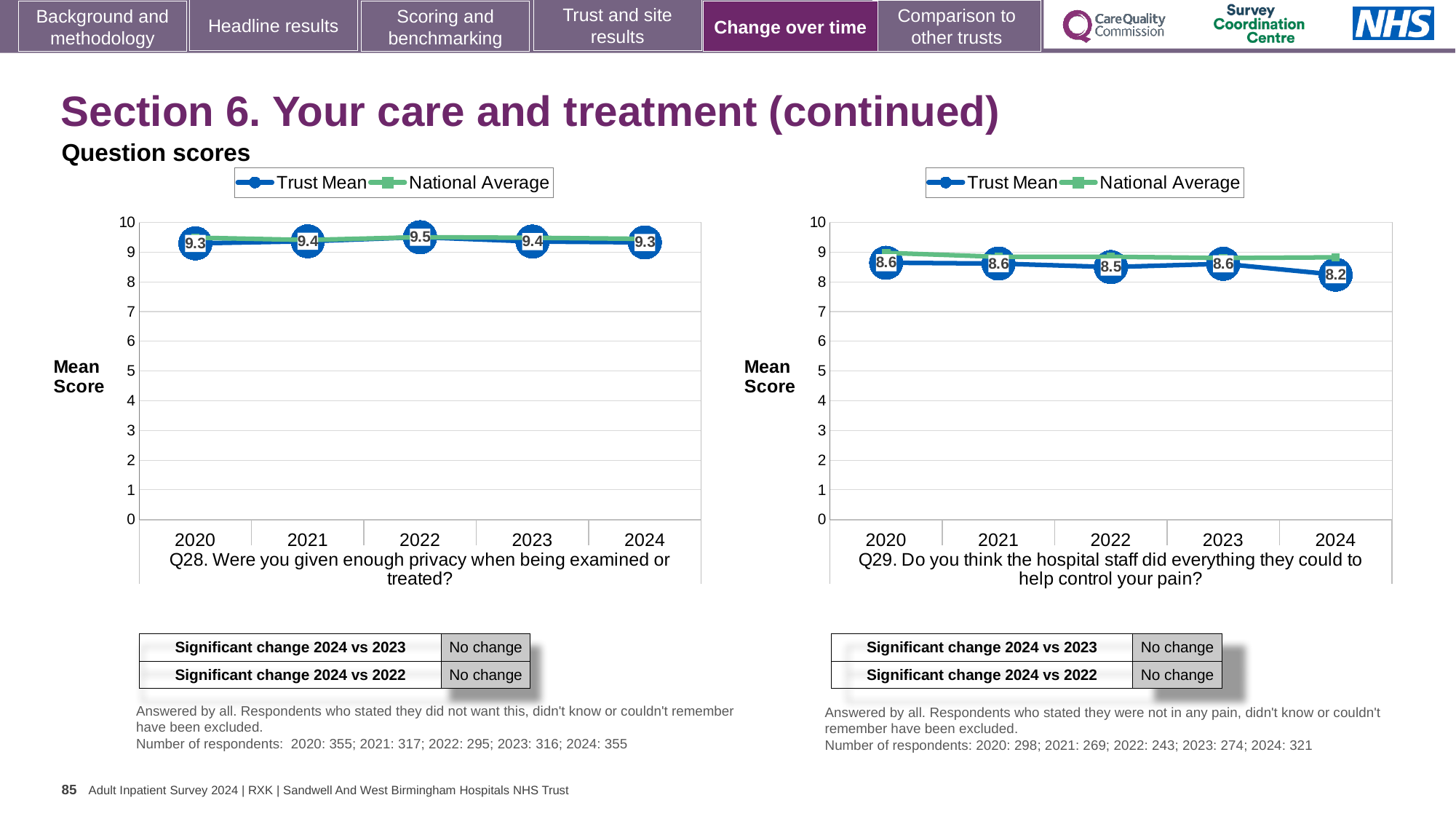
In the Q28 chart (left), which year has the highest Trust Mean score? 2022 How many years are plotted on the x axis of the Q28 chart (left)? 5 In the Q28 chart (left), what is the Trust Mean score for 2022? 9.5 In the Q29 chart (right), is the National Average value for 2024 greater or less than 8? greater What type of chart is the Q28 chart (left)? line chart In the Q28 chart (left), what is the Trust Mean score for 2024? 9.3 In the Q29 chart (right), what is the difference between the Trust Mean scores for 2023 and 2024? 0.4 In the Q28 chart (left), is the Trust Mean score for 2021 larger or smaller than the Trust Mean score for 2022? smaller In the Q29 chart (right), what is the Trust Mean score for 2022? 8.5 In the Q29 chart (right), which year has the lowest Trust Mean score? 2024 How many series does the legend of the Q29 chart (right) list? 2 In the Q29 chart (right), what is the Trust Mean score for 2024? 8.2